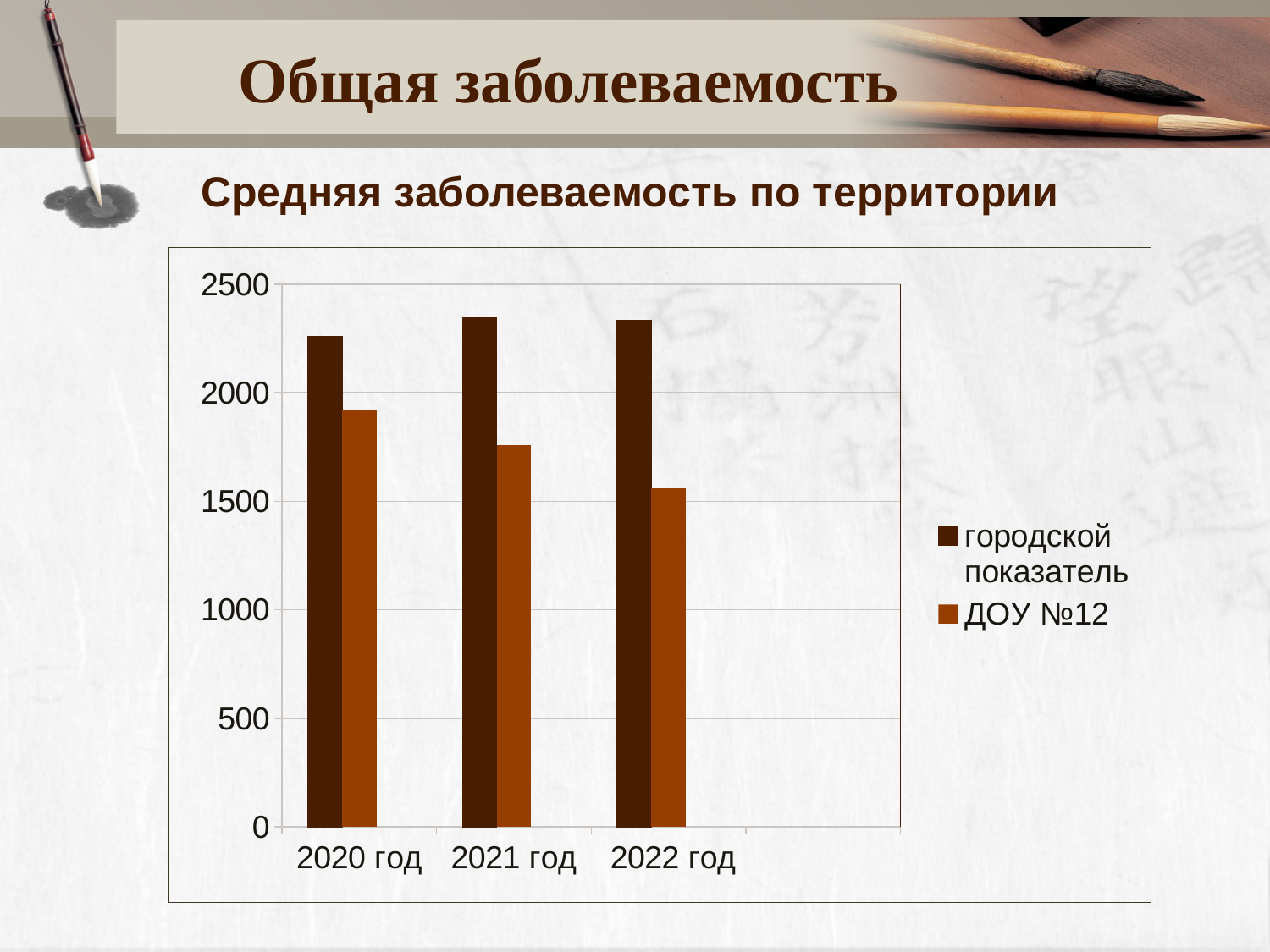
What kind of chart is shown on the slide? bar chart In which year is the value for ДОУ №12 the highest? 2020 год How many year categories are shown on the x axis? 3 In which year is the value for ДОУ №12 the lowest? 2022 год In 2022 год, which is larger: городской показатель or ДОУ №12? городской показатель What is the title shown above the chart? Средняя заболеваемость по территории Is the value for ДОУ №12 in 2022 год greater or less than 1500? greater Do the values for ДОУ №12 rise or fall from 2020 год to 2022 год? fall Is the value for ДОУ №12 in 2020 год greater or less than 2000? less How many series does the legend list? 2 Is the value for городской показатель in 2021 год greater or less than 2000? greater Which series does the orange colour represent in the legend? ДОУ №12